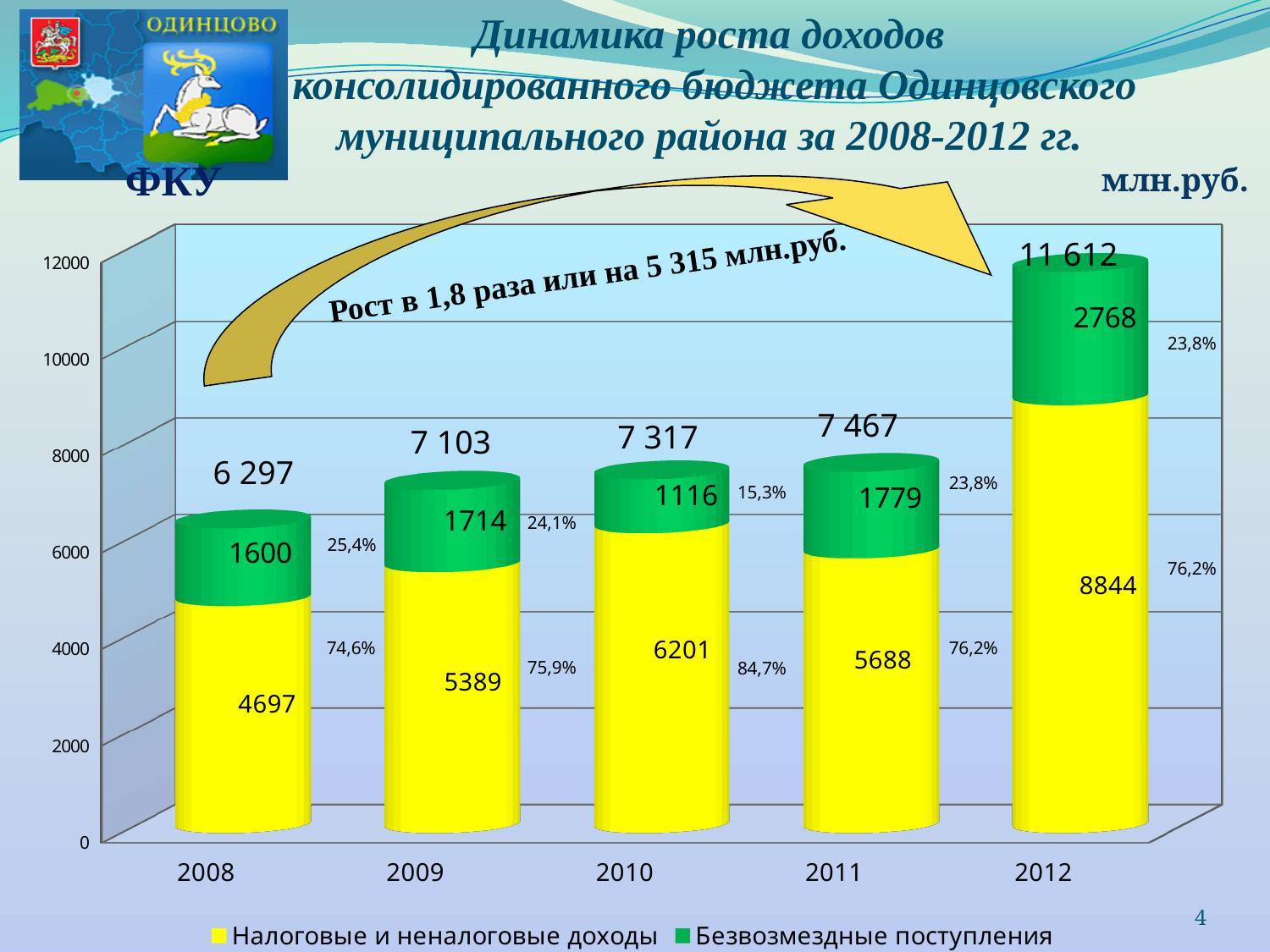
What is the value of Безвозмездные поступления for 2010? 1116 What kind of chart is shown on the slide? Stacked bar chart What is the value of Налоговые и неналоговые доходы for 2012? 8844 What percentage label is shown for Безвозмездные поступления in 2008? 25,4% How many years are shown on the x axis? 5 Do the total incomes rise or fall from 2008 to 2012? Rise Which year has the lowest total income? 2008 Which year has the highest total income? 2012 What is the total shown above the stacked bar for 2009? 7 103 Which is larger: Безвозмездные поступления in 2009 or in 2011? 2011 What is the difference between the Налоговые и неналоговые доходы values for 2012 and 2011? 3156 How many series does the legend list? 2